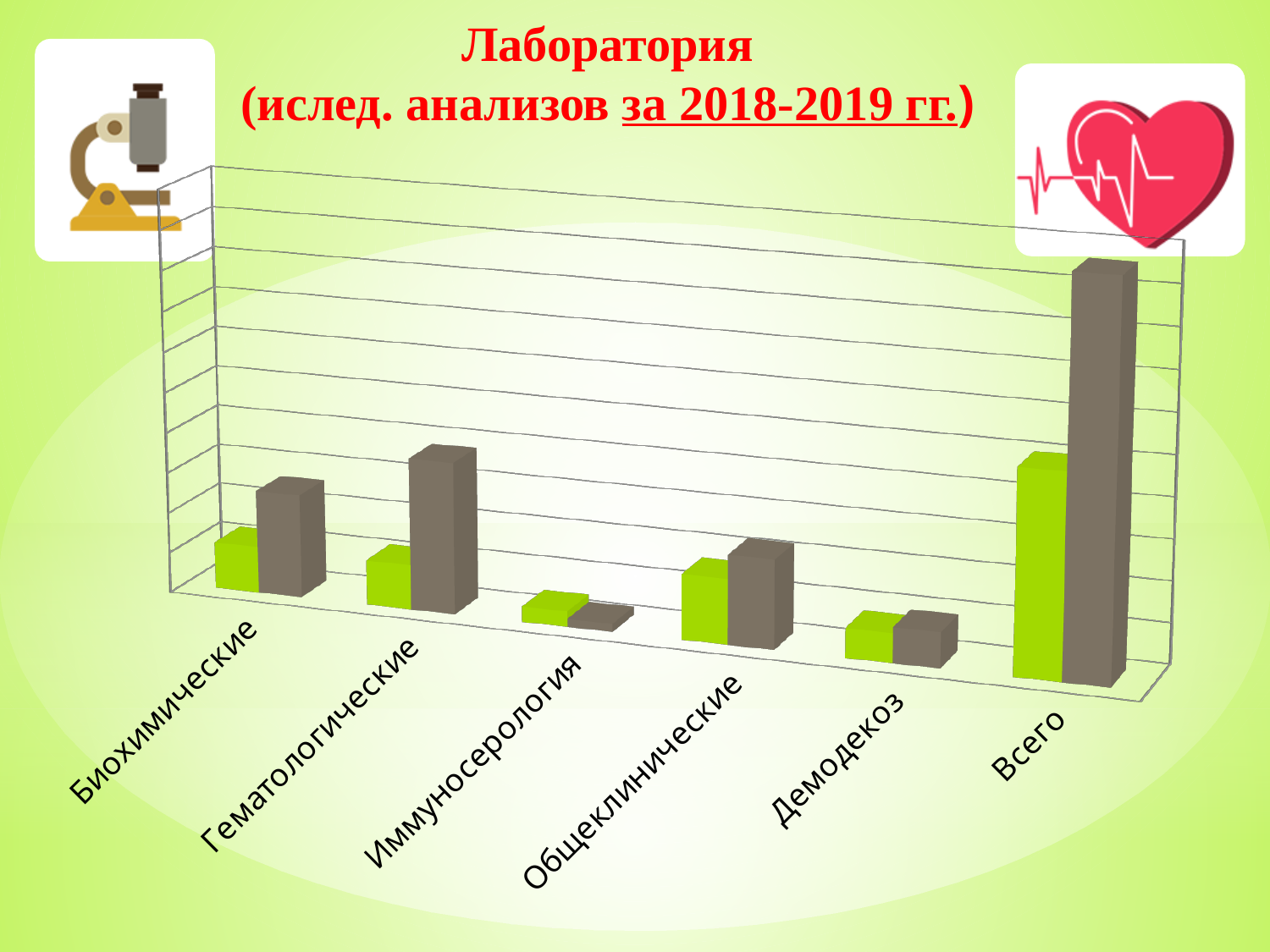
How many bars are plotted for each category in the chart? 2 Which category has the shortest brown bar in the chart? Иммуносерология Which category has the tallest green bar in the chart? Всего For the category Биохимические, which bar is taller, the green one or the brown one? the brown one Is the brown bar taller for Гематологические or for Биохимические? Гематологические How many categories are shown along the x axis of the chart? 6 Is the brown bar taller for Общеклинические or for Демодекоз? Общеклинические What is the title of the slide containing the chart? Лаборатория (ислед. анализов за 2018-2019 гг.) What two colours are used for the bars in the chart? green and brown What kind of chart is shown on the slide? bar chart Which category has the tallest brown bar in the chart? Всего